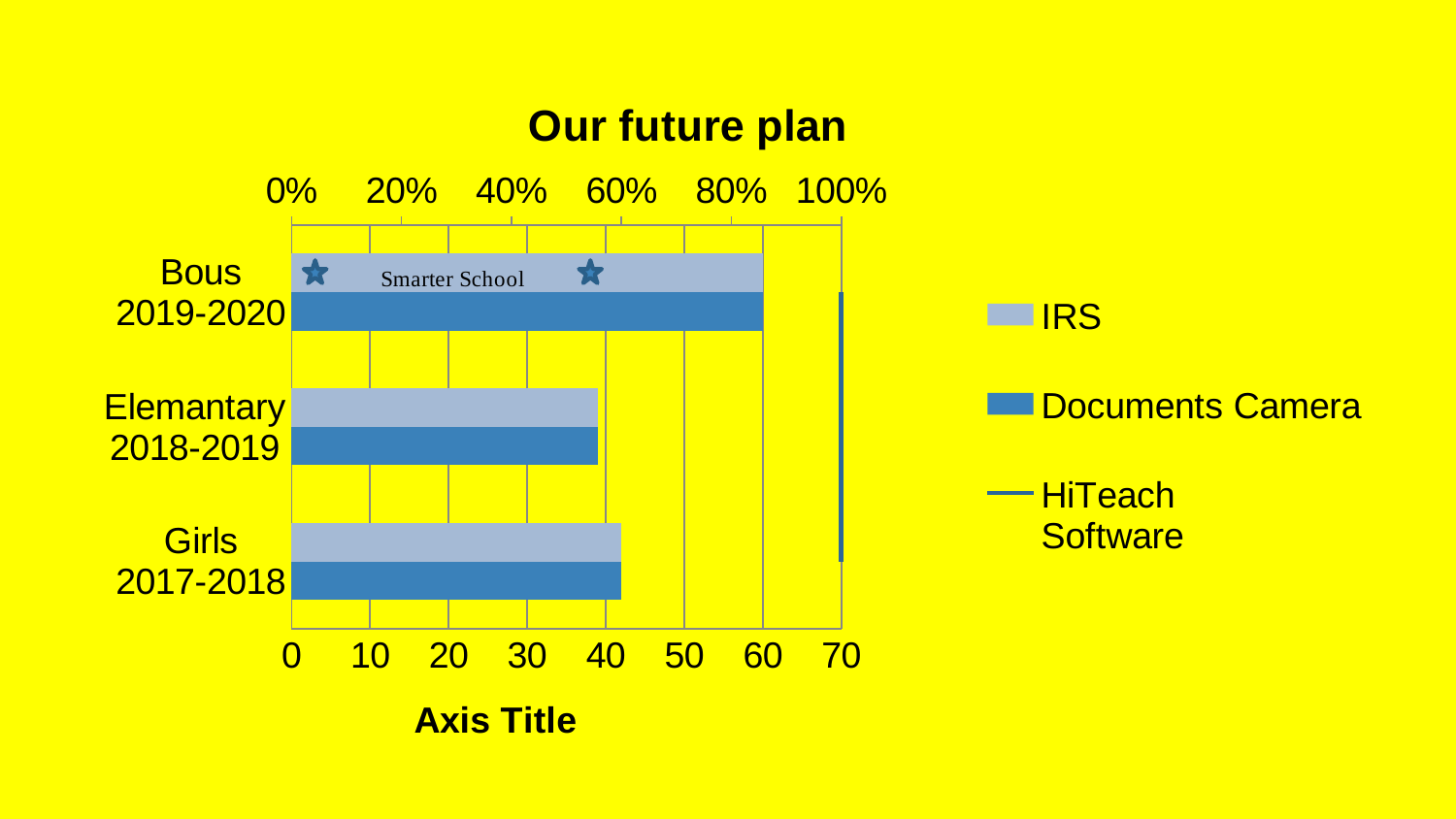
Is the IRS value for Bous 2019-2020 greater or less than 50? greater Which category has the highest value for Documents Camera? Bous 2019-2020 What is the title of the chart? Our future plan Is the IRS value for Elemantary 2018-2019 greater or less than 50? less How many series does the legend list? 3 What kind of chart is shown on the slide? combination bar and line chart What is the label of the horizontal axis at the bottom of the chart? Axis Title Is the Documents Camera value for Girls 2017-2018 greater or less than 50? less How many categories are shown on the chart? 3 Which category has the highest value for IRS? Bous 2019-2020 What is the Documents Camera value for Bous 2019-2020 on the bottom axis? 60 Which is larger, the Documents Camera value for Bous 2019-2020 or for Girls 2017-2018? Bous 2019-2020